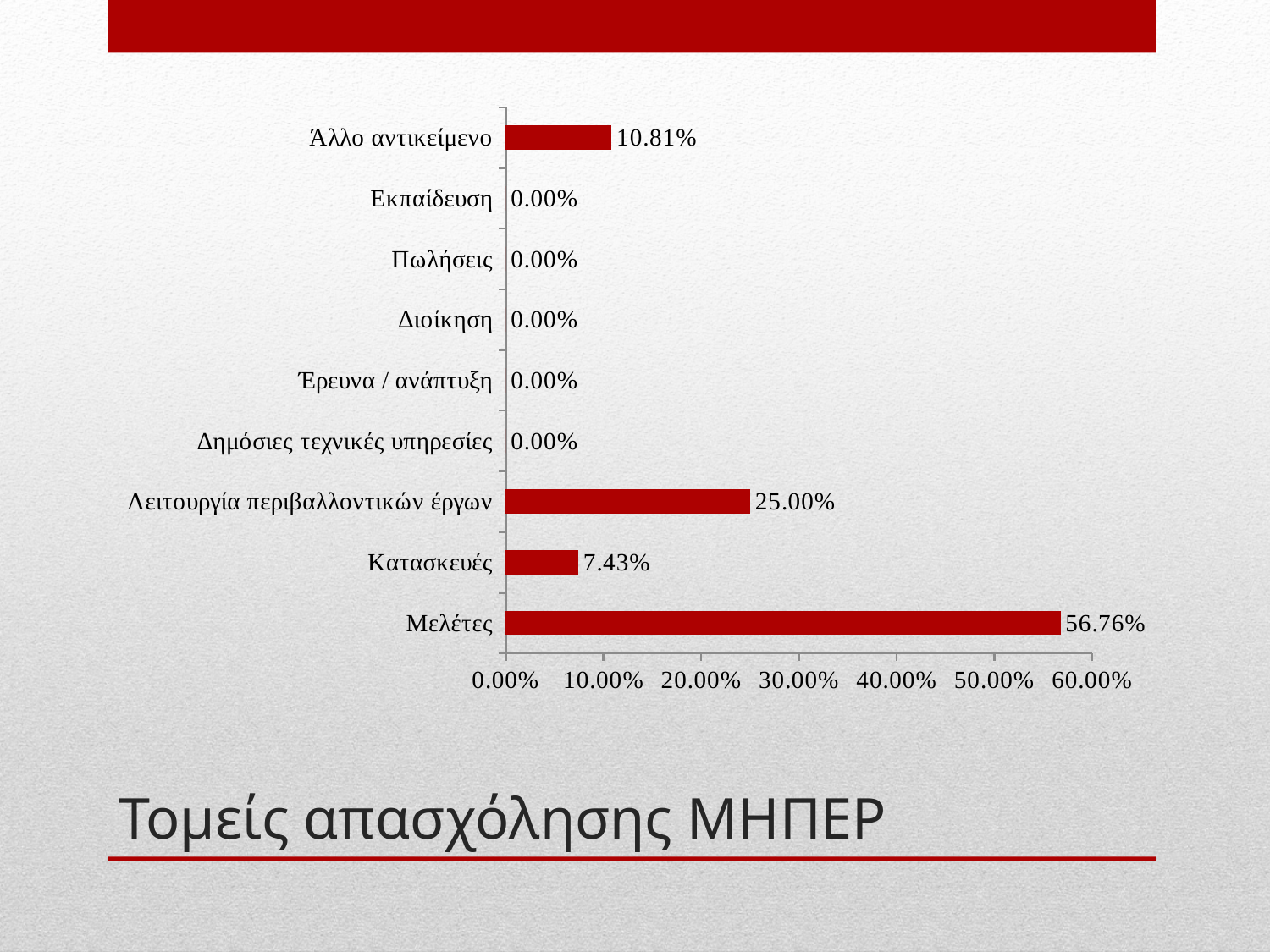
What is the difference between the values for Άλλο αντικείμενο and Κατασκευές? 3.38% What is the value for Εκπαίδευση? 0.00% What is the value for Άλλο αντικείμενο? 10.81% What is the value for Λειτουργία περιβαλλοντικών έργων? 25.00% How many categories have a value of 0.00%? 5 What is the difference between the values for Μελέτες and Λειτουργία περιβαλλοντικών έργων? 31.76% What kind of chart is shown on the slide? Bar chart How many categories are shown on the chart? 9 Which category has the highest value? Μελέτες Which is larger, the value for Άλλο αντικείμενο or the value for Κατασκευές? Άλλο αντικείμενο What is the value for Κατασκευές? 7.43% What is the value for Μελέτες? 56.76%